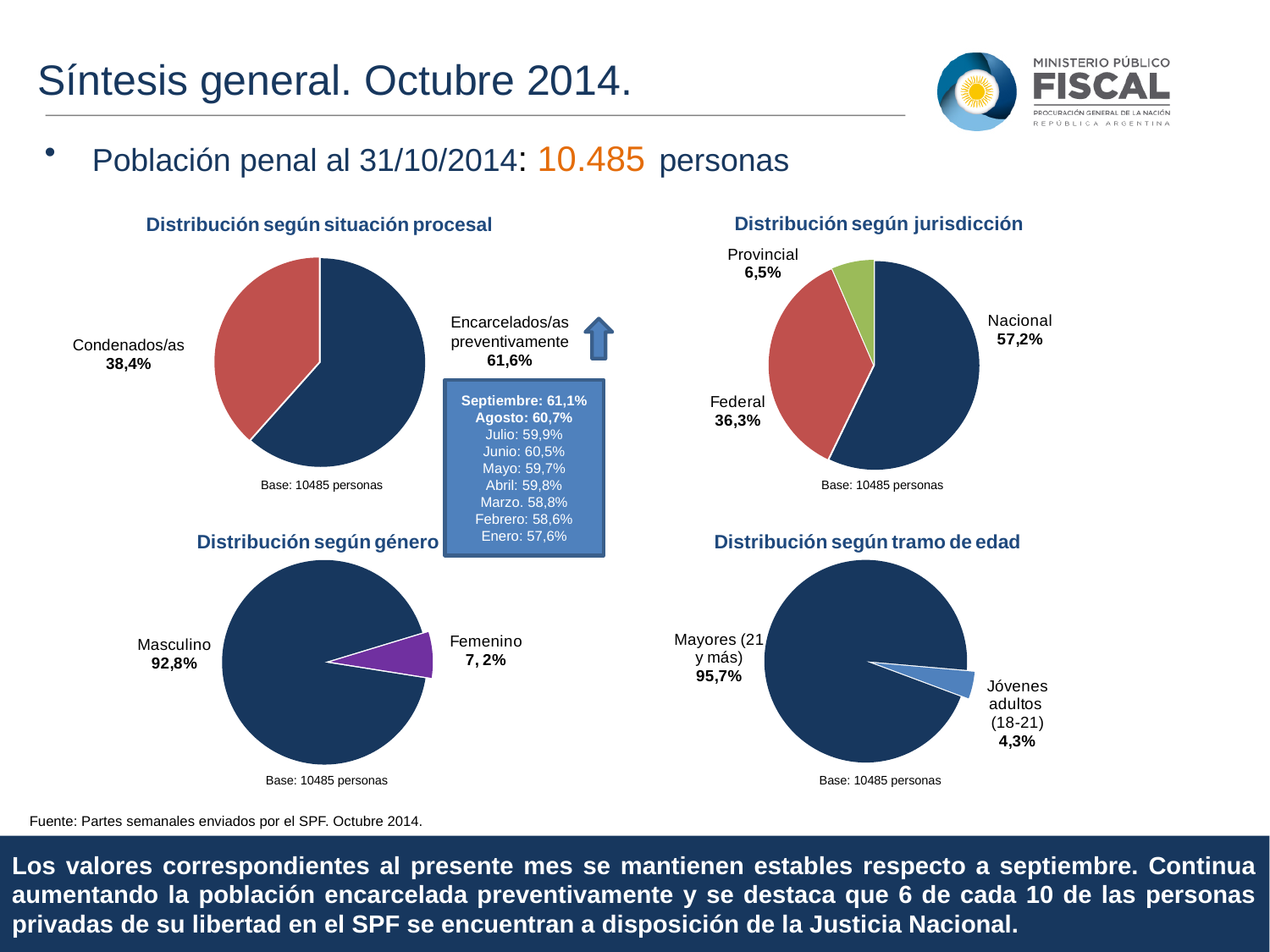
In the 'Distribución según jurisdicción' chart, what share is labelled for Federal? 36,3% In the 'Distribución según tramo de edad' chart, what share is labelled for Jóvenes adultos (18-21)? 4,3% What base (number of persons) is stated under the 'Distribución según género' chart? 10485 personas In the 'Distribución según género' chart, what share is labelled for Masculino? 92,8% In the 'Distribución según situación procesal' chart, what share is labelled for Condenados/as? 38,4% In the 'Distribución según situación procesal' chart, what share is labelled for Encarcelados/as preventivamente? 61,6% What type of chart is used for 'Distribución según situación procesal'? Pie chart In the 'Distribución según tramo de edad' chart, which category is larger, Mayores (21 y más) or Jóvenes adultos (18-21)? Mayores (21 y más) In the 'Distribución según jurisdicción' chart, which category has the smallest share? Provincial In the 'Distribución según jurisdicción' chart, what is the difference between the Nacional and Federal shares? 20,9 percentage points In the 'Distribución según jurisdicción' chart, how many categories are shown? 3 In the 'Distribución según jurisdicción' chart, which category has the largest share? Nacional